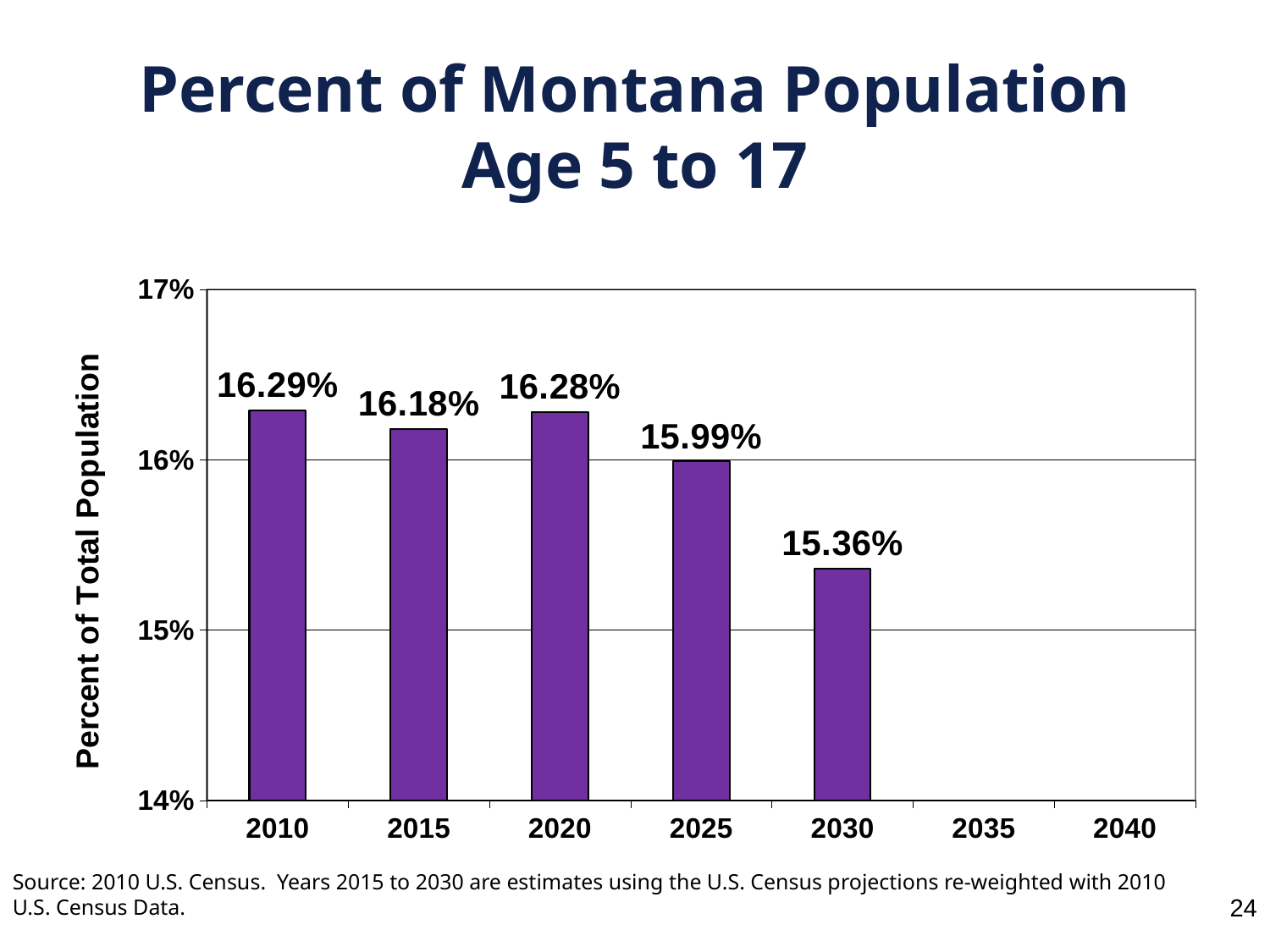
What is the value for 2030? 15.36% What is the difference between the values for 2010 and 2030? 0.93% What kind of chart is shown? bar chart What is the y-axis title of the chart? Percent of Total Population Which is larger, the value for 2015 or the value for 2025? 2015 Which year has the lowest value? 2030 What is the value for 2025? 15.99% What is the value for 2010? 16.29% Is the value for 2030 greater or less than 16%? less Which year has the highest value? 2010 How many bars have data labels on the chart? 5 What is the difference between the values for 2020 and 2025? 0.29%